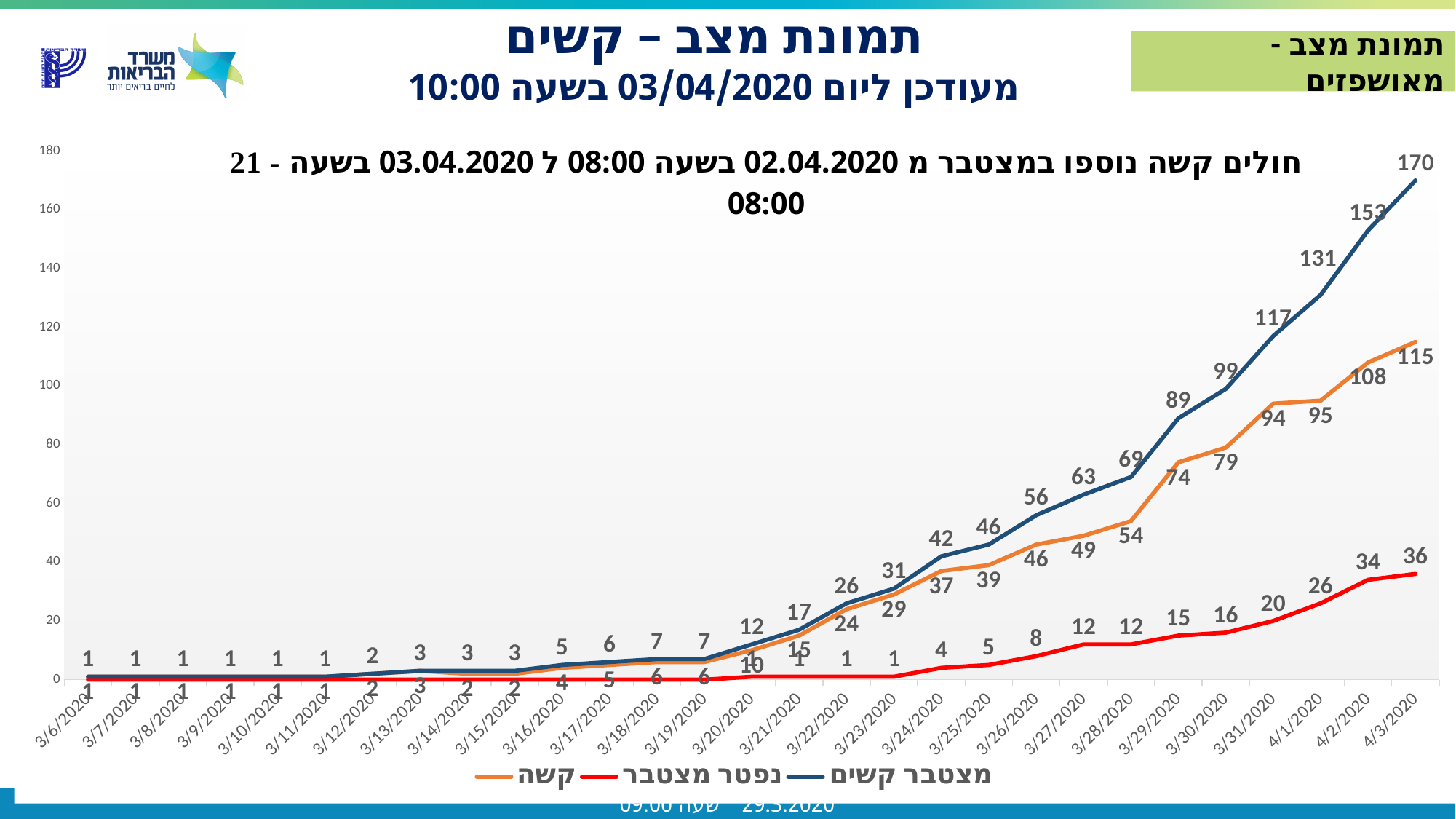
Does the מצטבר קשים series rise or fall from 3/6/2020 to 4/3/2020? Rise How many series does the legend list? 3 By how much did the מצטבר קשים series increase from 4/2/2020 to 4/3/2020? 17 What is the value of the נפטר מצטבר series on 3/31/2020? 20 What is the value of the קשה series on 4/2/2020? 108 What kind of chart is shown on the slide? Line chart On which date does the מצטבר קשים series reach its highest value? 4/3/2020 What is the difference between the מצטבר קשים value and the קשה value on 4/3/2020? 55 What is the value of the נפטר מצטבר series on 4/3/2020? 36 Which is larger on 3/28/2020: the מצטבר קשים value or the קשה value? מצטבר קשים What is the value of the מצטבר קשים series on 3/29/2020? 89 What is the value of the מצטבר קשים series on 4/3/2020? 170